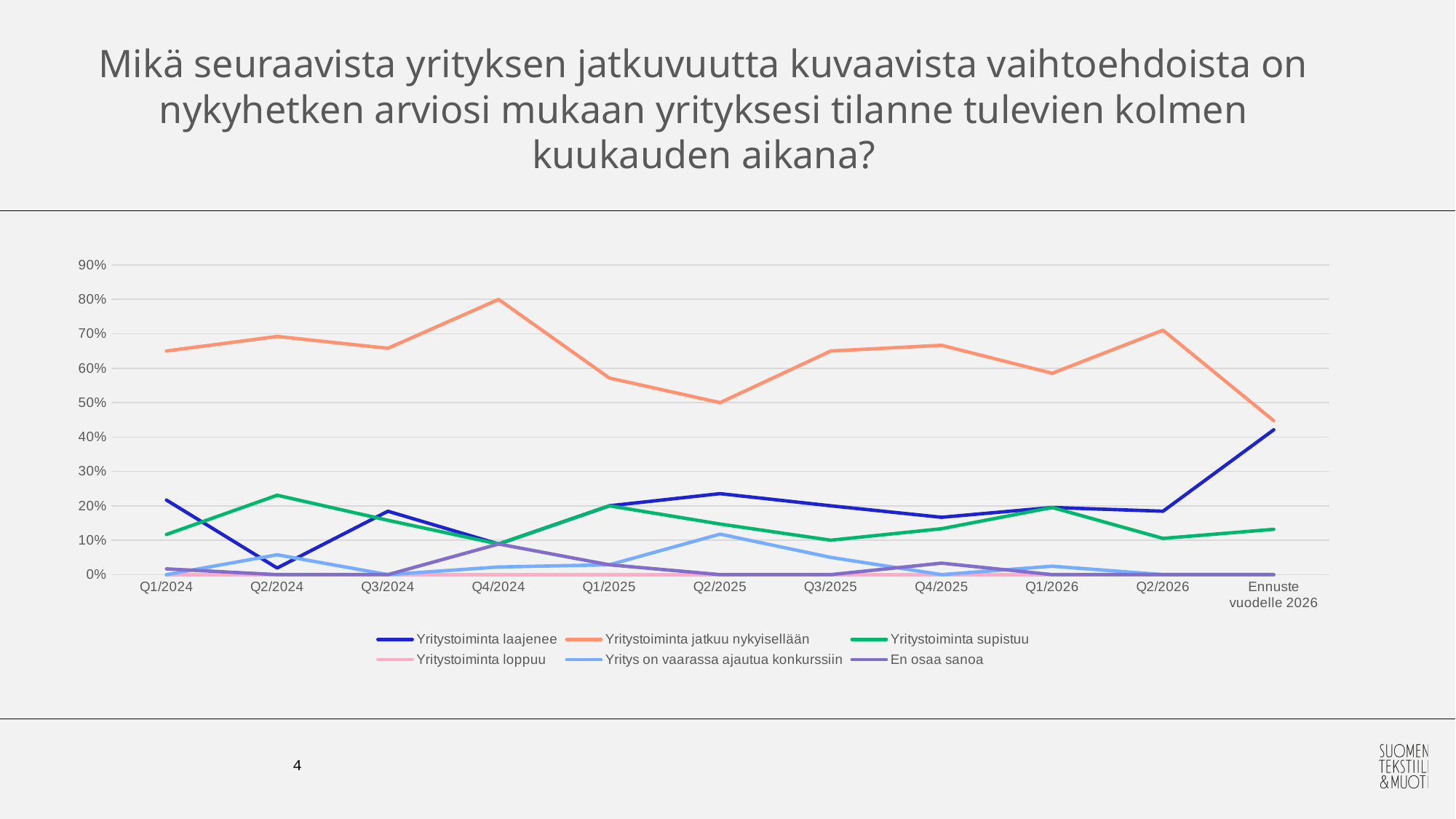
What kind of chart is shown on the slide? line chart Is the value for "Yritystoiminta jatkuu nykyisellään" at Q2/2025 greater or less than 60%? less At Q2/2024, which series has the larger value: "Yritystoiminta supistuu" or "Yritystoiminta laajenee"? Yritystoiminta supistuu How many categories are shown on the x axis? 11 In which category does the series "Yritystoiminta jatkuu nykyisellään" reach its highest value? Q4/2024 Is the value for "Yritystoiminta laajenee" at Ennuste vuodelle 2026 greater or less than 30%? greater Does the series "Yritystoiminta jatkuu nykyisellään" rise or fall from Q2/2026 to Ennuste vuodelle 2026? fall In which category does the series "Yritystoiminta jatkuu nykyisellään" have its lowest value? Ennuste vuodelle 2026 In which category does the series "Yritystoiminta laajenee" reach its highest value? Ennuste vuodelle 2026 Is the value for "Yritystoiminta jatkuu nykyisellään" at Q4/2024 greater or less than 70%? greater At Q1/2024, which series has the larger value: "Yritystoiminta laajenee" or "Yritystoiminta supistuu"? Yritystoiminta laajenee How many series does the legend list? 6